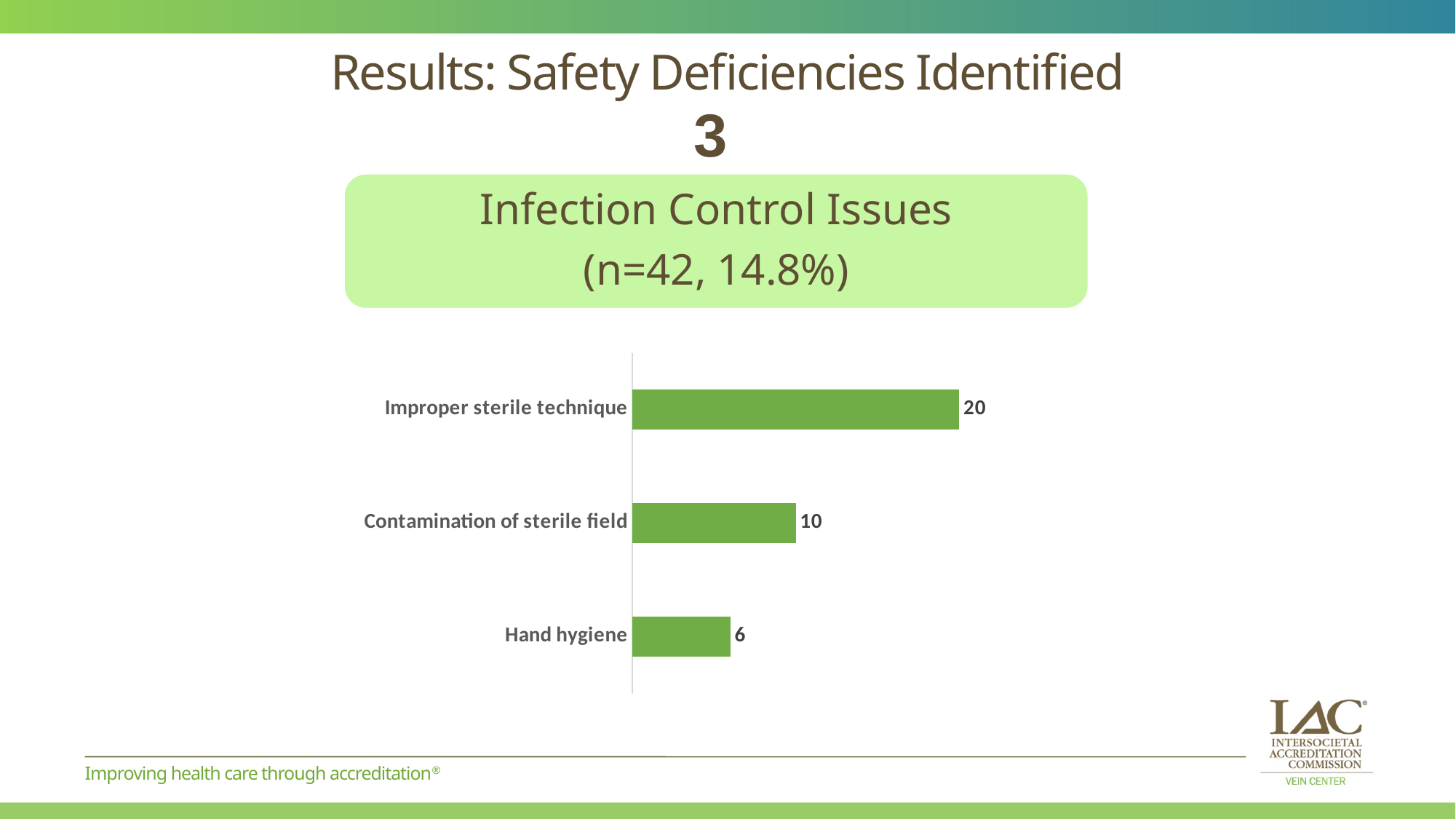
What is the value for Improper sterile technique? 20 What kind of chart is shown on the slide? Bar chart How many categories are shown in the chart? 3 What is the value for Contamination of sterile field? 10 Which category has the lowest value? Hand hygiene What is the difference between the values for Contamination of sterile field and Hand hygiene? 4 What is the difference between the values for Improper sterile technique and Contamination of sterile field? 10 What is the value for Hand hygiene? 6 Which is larger, the value for Contamination of sterile field or the value for Hand hygiene? Contamination of sterile field What colour are the bars in the chart? Green Which category has the highest value? Improper sterile technique What is the total of the three values shown in the chart? 36